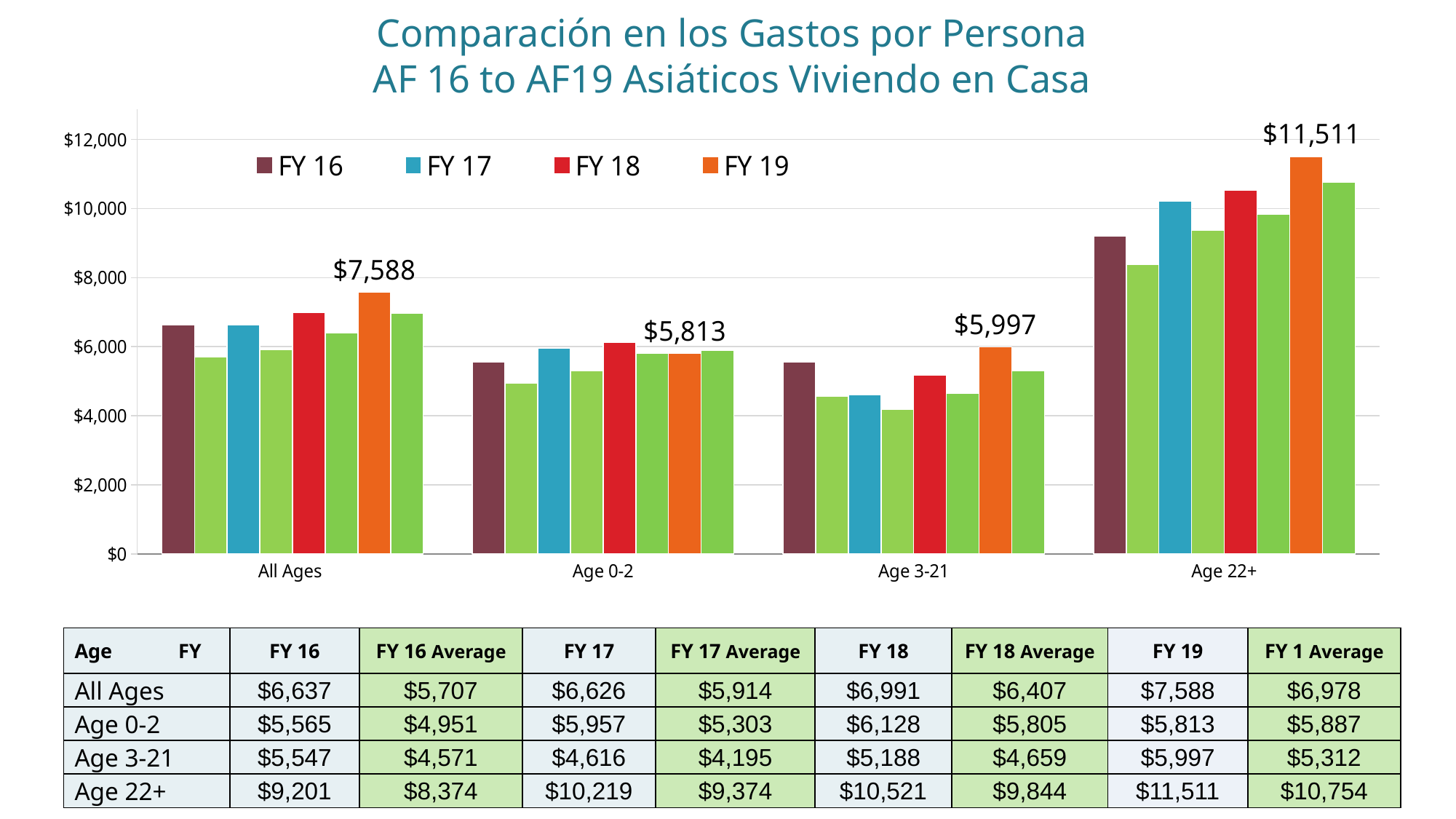
What is the FY 19 value labelled above the Age 22+ group in the chart? $11,511 What kind of chart is shown on the slide? bar chart Which is larger in the chart: the FY 19 value for Age 3-21 or the FY 19 value for Age 0-2? Age 3-21 Which age category has the highest FY 19 value in the chart? Age 22+ What is the difference between the FY 19 values for Age 22+ and All Ages? $3,923 What is the FY 19 value labelled above the All Ages group in the chart? $7,588 Which colour represents FY 19 in the chart legend? orange How many age categories are shown along the x axis of the chart? 4 Is the FY 16 value for Age 22+ greater or less than $8,000? greater How many series does the chart legend list? 4 What is the FY 19 value labelled above the Age 3-21 group in the chart? $5,997 Which age category has the lowest FY 19 value in the chart? Age 0-2